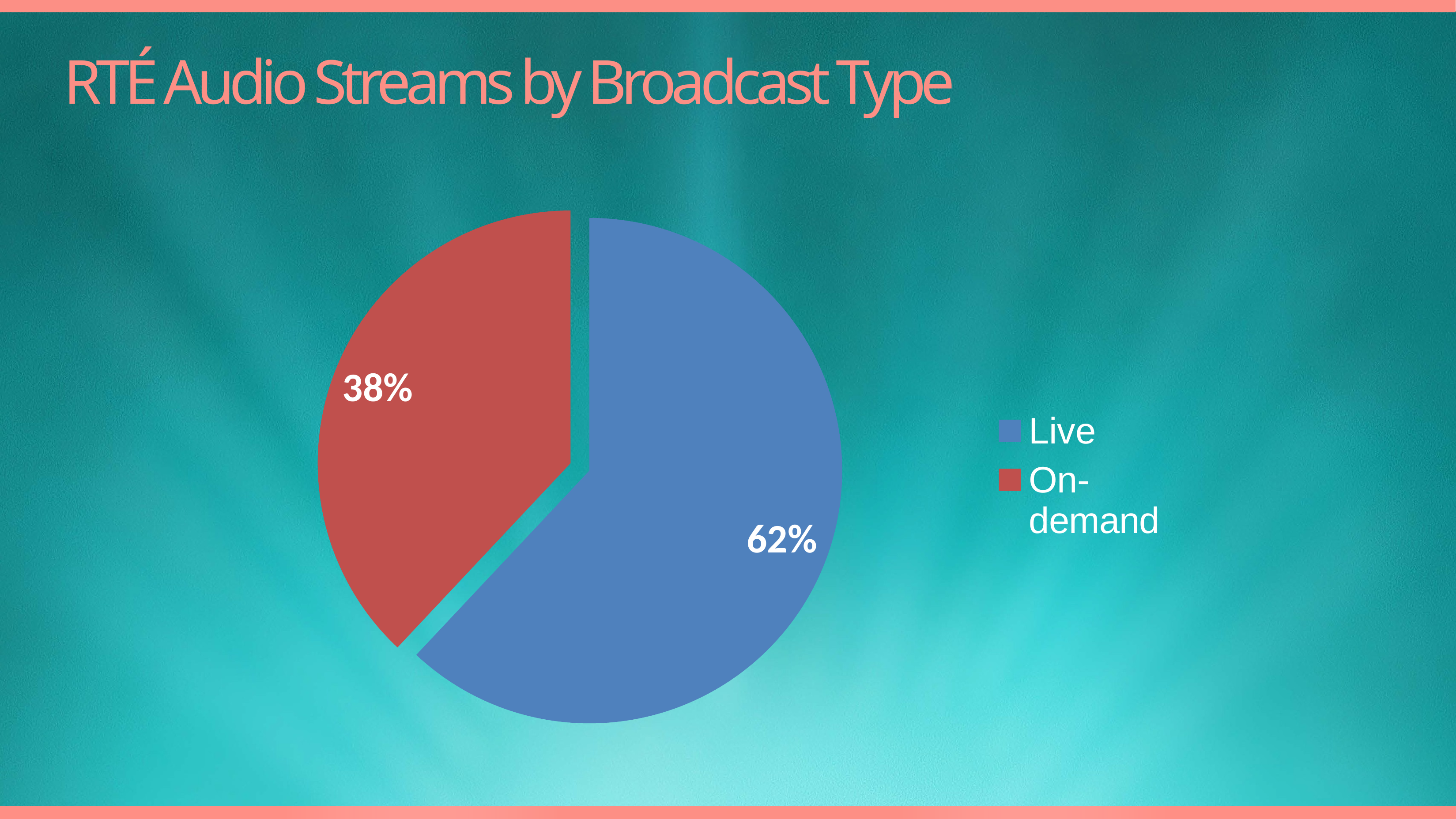
What share of the pie does the On-demand slice represent? 38% How many entries does the legend list? 2 Which broadcast type has the smallest share of audio streams? On-demand What percentage of RTÉ audio streams are Live? 62% What is the title of the chart? RTÉ Audio Streams by Broadcast Type Which broadcast type has the largest share of audio streams? Live How many slices does the pie chart have? 2 What percentage of RTÉ audio streams are On-demand? 38% What type of chart is shown on the slide? Pie chart Which is larger, the Live share or the On-demand share? Live What colour is the Live slice? Blue What is the difference in percentage points between the Live and On-demand shares? 24